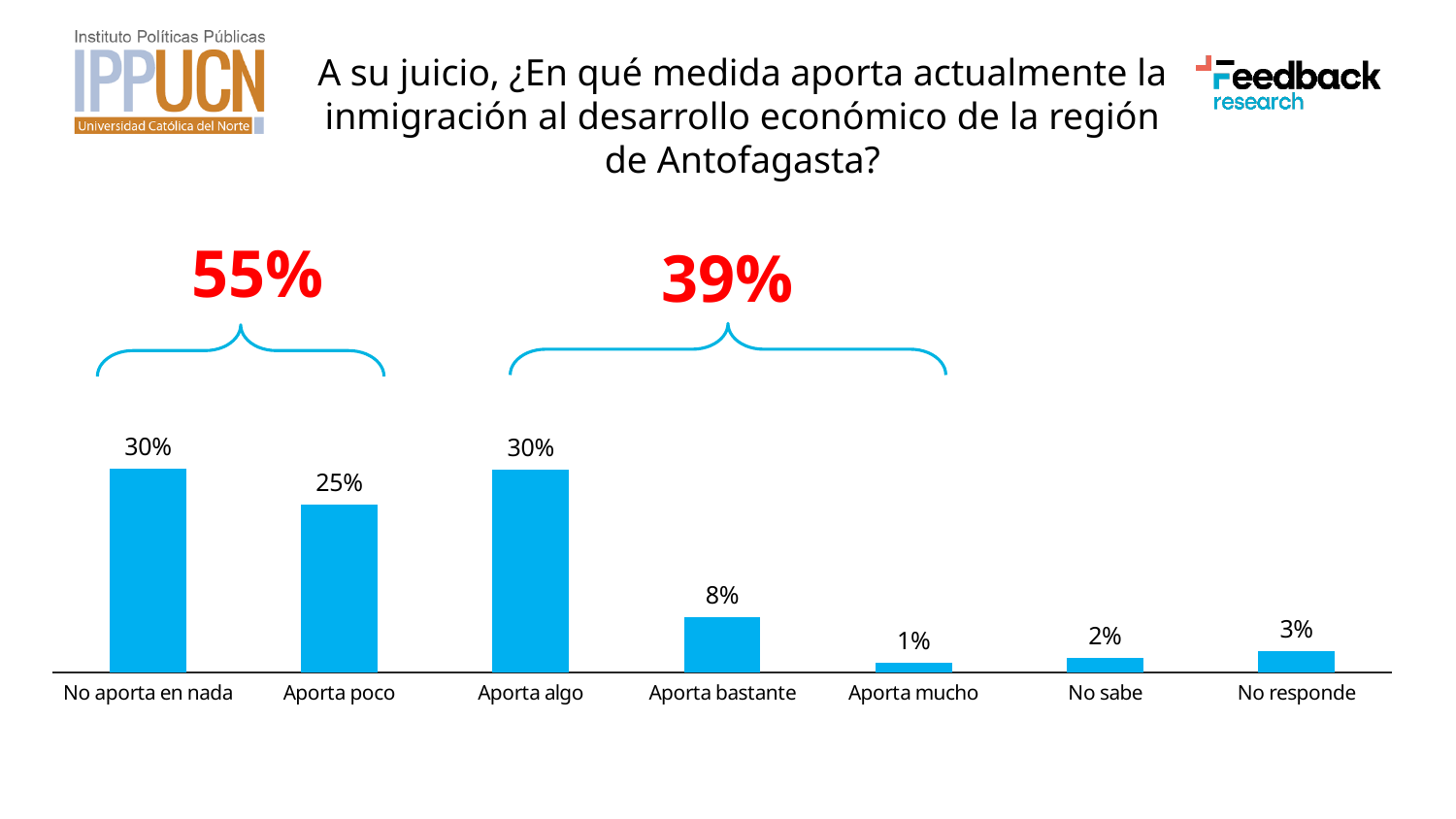
What is the value for "Aporta mucho"? 1% What is the difference between the values for "No aporta en nada" and "Aporta poco"? 5% Which is larger, the value for "Aporta bastante" or the value for "No sabe"? Aporta bastante What percentage is shown for "No responde"? 3% What combined percentage is shown in red above the bracket covering "No aporta en nada" and "Aporta poco"? 55% What is the difference between the values for "Aporta algo" and "Aporta bastante"? 22% What combined percentage is shown in red above the bracket covering "Aporta algo", "Aporta bastante" and "Aporta mucho"? 39% How many categories are shown on the x axis? 7 What percentage of respondents answered "Aporta poco"? 25% Which category has the lowest value? Aporta mucho What is the value shown for "Aporta bastante"? 8% What kind of chart is shown on the slide? Bar chart